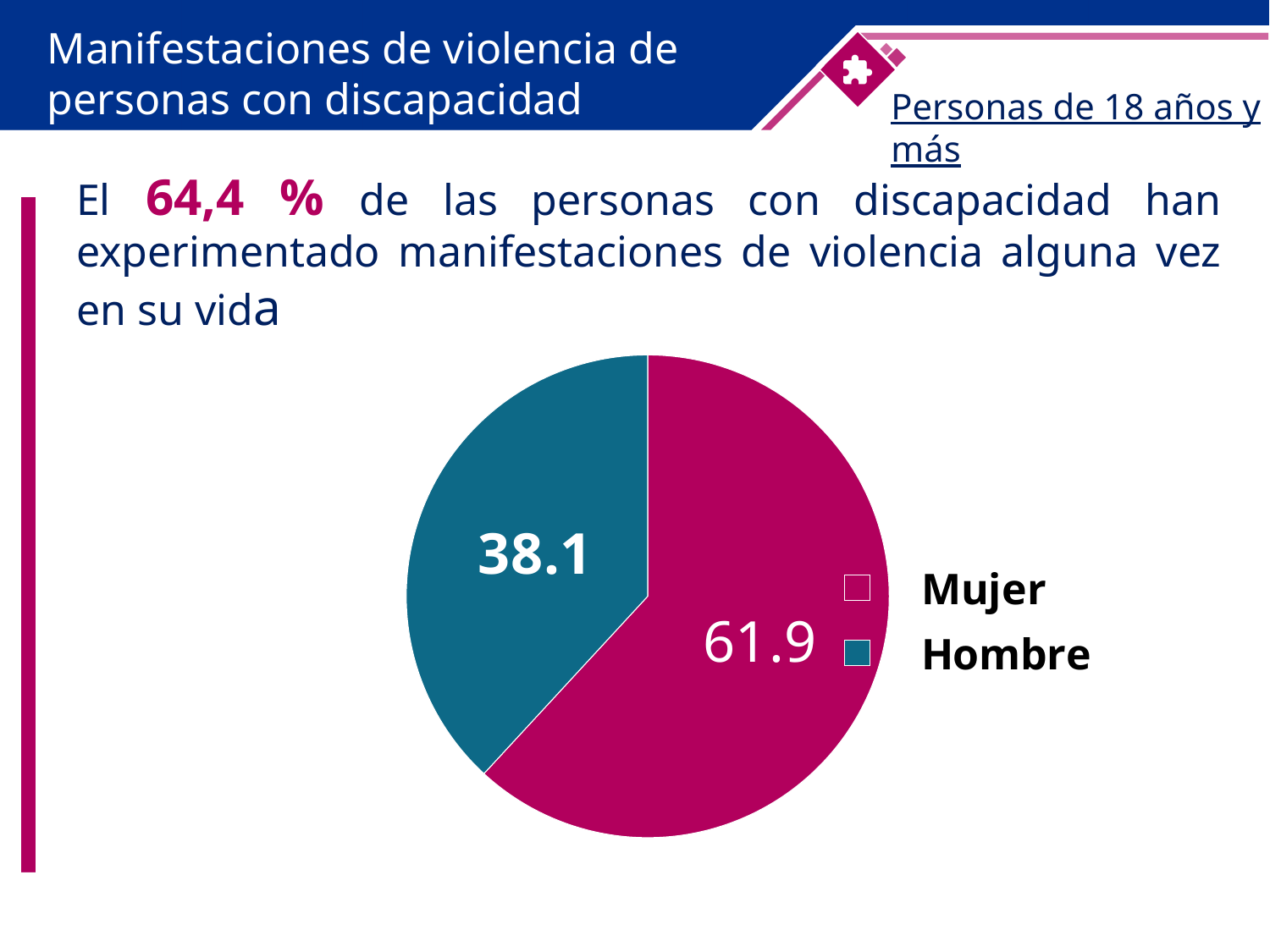
Which category has the smallest slice in the pie chart? Hombre What is the sum of the two values shown in the pie chart? 100 What is the difference between the values for Mujer and Hombre in the pie chart? 23.8 What is the value shown for Hombre in the pie chart? 38.1 What is the value shown for Mujer in the pie chart? 61.9 How many slices does the pie chart have? 2 What are the two legend entries of the pie chart? Mujer and Hombre Which category has the largest slice in the pie chart? Mujer What percentage of people with disabilities does the slide text say have experienced manifestations of violence at some point in their lives? 64,4 % What kind of chart is shown on the slide? Pie chart How many entries does the legend of the pie chart list? 2 Which is larger in the pie chart, the value for Mujer or the value for Hombre? Mujer